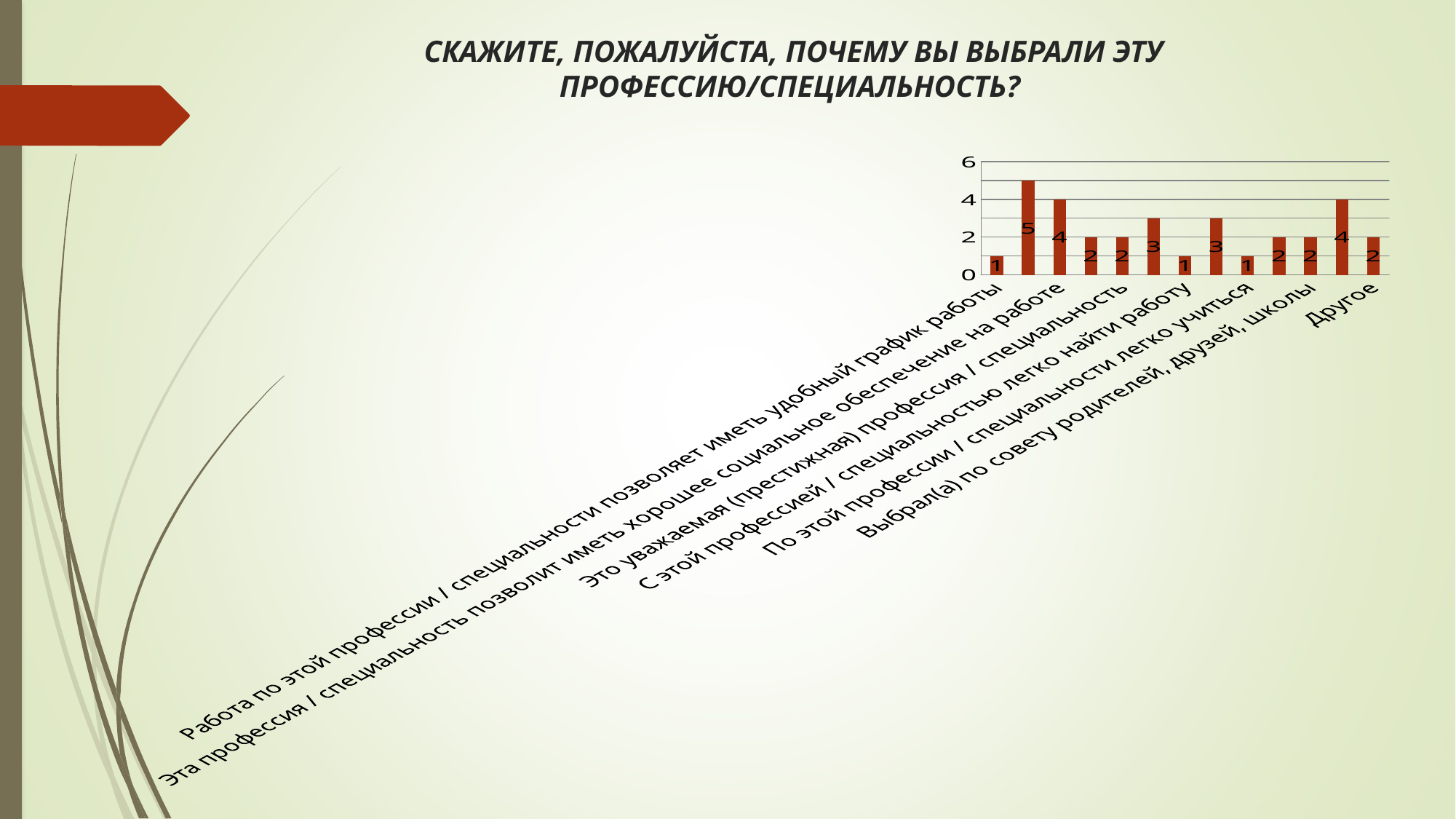
What is the title of the slide containing the chart? СКАЖИТЕ, ПОЖАЛУЙСТА, ПОЧЕМУ ВЫ ВЫБРАЛИ ЭТУ ПРОФЕССИЮ/СПЕЦИАЛЬНОСТЬ? Is the value for "Другое" greater or less than 4? less What is the value for the category "Работа по этой профессии / специальности позволяет иметь удобный график работы"? 1 What is the maximum value shown on the vertical axis? 6 What is the lowest value shown by any bar in the chart? 1 What is the value for the category "Выбрал(а) по совету родителей, друзей, школы"? 2 What is the difference between the highest bar value and the lowest bar value in the chart? 4 What is the value for the category "Другое"? 2 How many bars are plotted in the chart? 13 What is the highest value shown by any bar in the chart? 5 How many bars in the chart have a value of 4? 2 What kind of chart is shown on the slide? bar chart